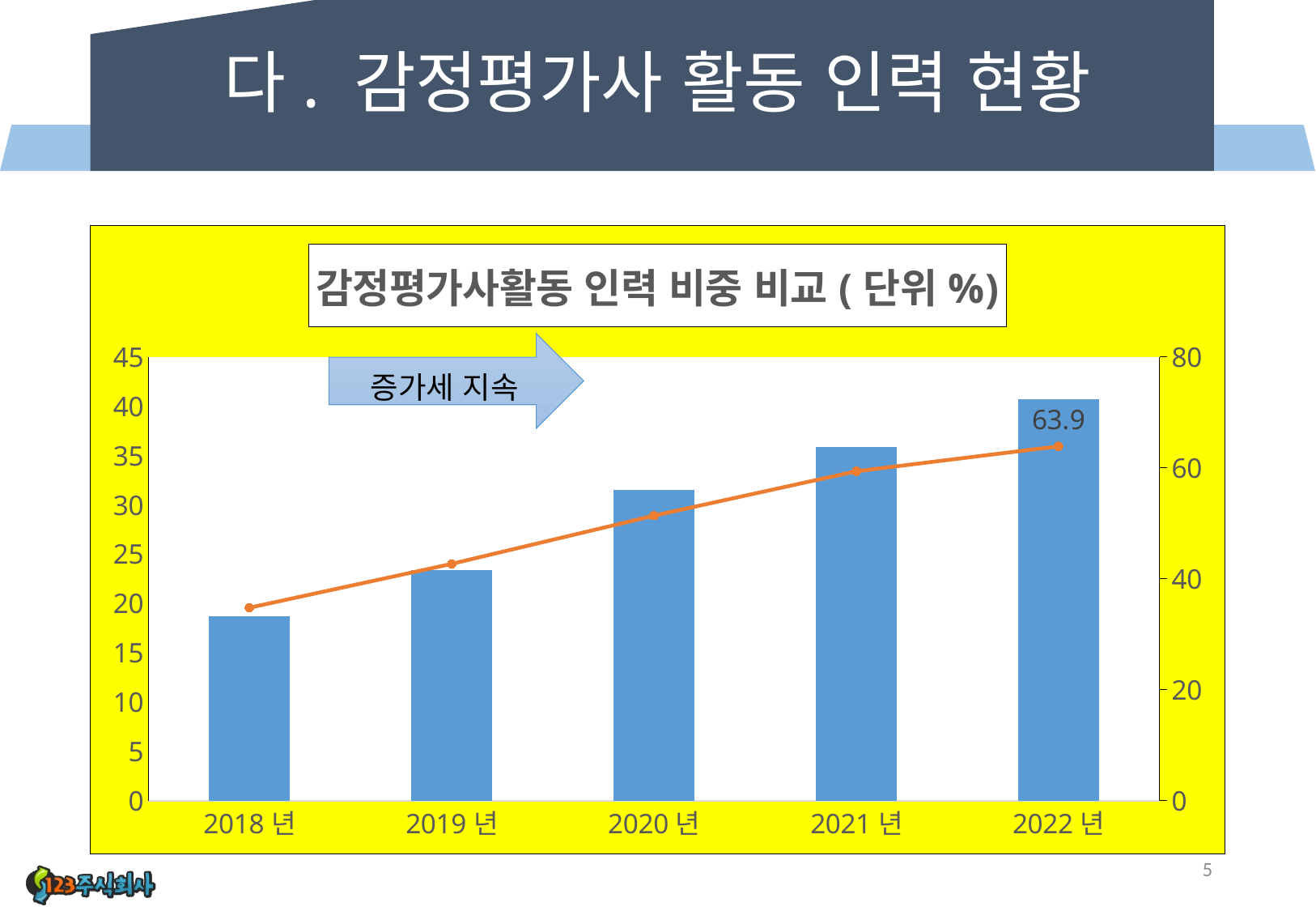
Which bar is taller, 2018 년 or 2022 년? 2022 년 Do the bar values rise or fall from 2018 년 to 2022 년? Rise How many years are shown on the x axis? 5 Is the line value for 2018 년 greater or less than 40 on the right axis? less Is the bar value for 2018 년 greater or less than 20 on the left axis? less Is the bar value for 2020 년 greater or less than 30 on the left axis? greater What kind of chart is this? Bar chart with a line What is the value of the line series for 2022 년? 63.9 What is the title of the chart? 감정평가사활동 인력 비중 비교 ( 단위 %) Which year has the shortest bar? 2018 년 What text is written inside the arrow annotation on the chart? 증가세 지속 Which year has the tallest bar? 2022 년